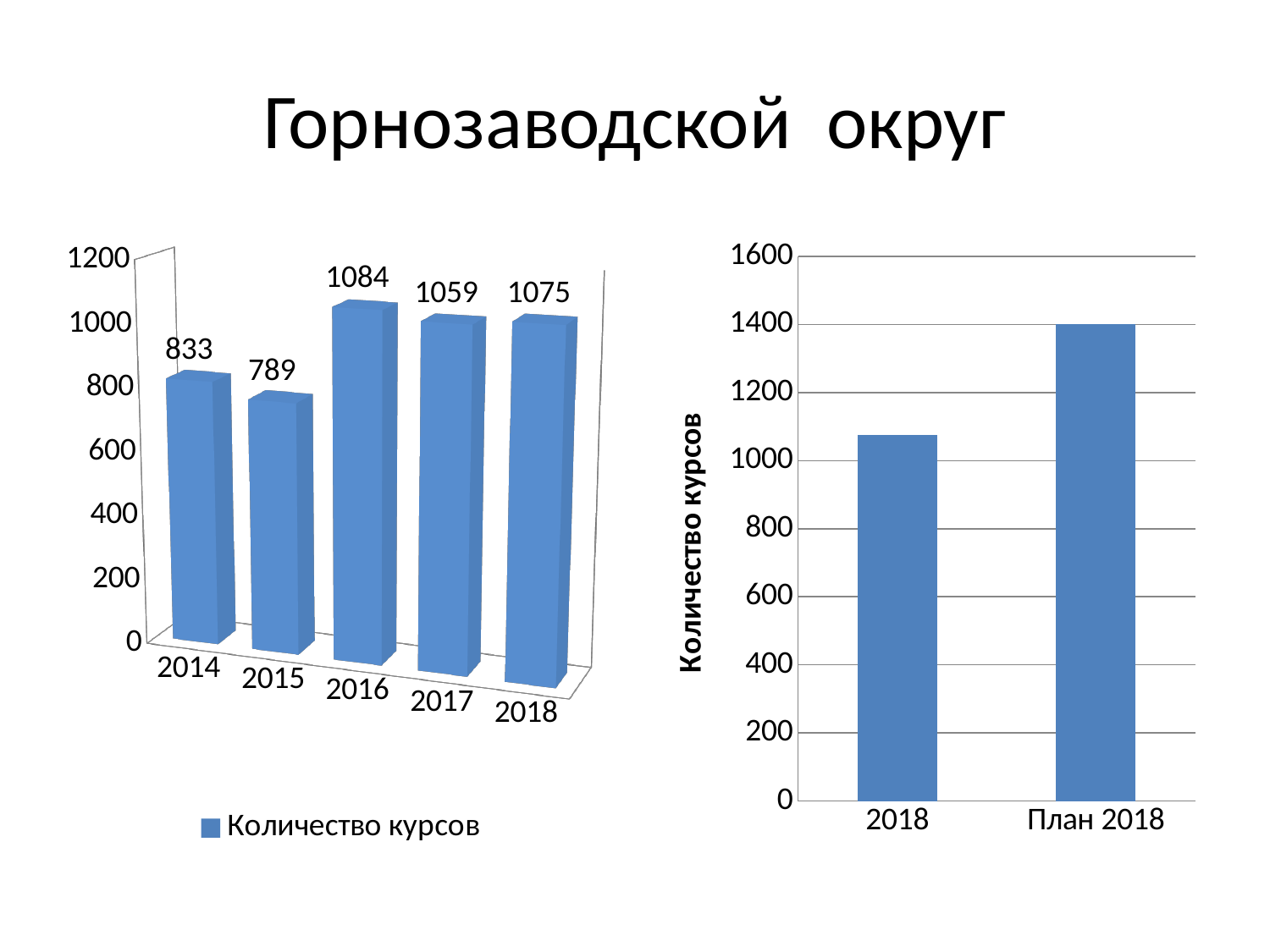
In the left chart, which year has the lowest value? 2015 In the right chart, is the value for План 2018 greater or less than 1200? greater In the left chart, which is larger, the value for 2017 or the value for 2018? 2018 In the left chart, which year has the highest value? 2016 In the left chart, what is the value for 2016? 1084 In the left chart, what is the difference between the values for 2016 and 2015? 295 In the left chart, what is the value for 2014? 833 What kind of chart is the left chart? bar chart In the right chart, which is larger, 2018 or План 2018? План 2018 In the right chart, what is the label on the vertical axis? Количество курсов In the left chart, what series name does the legend show? Количество курсов In the left chart, how many years are shown on the x axis? 5